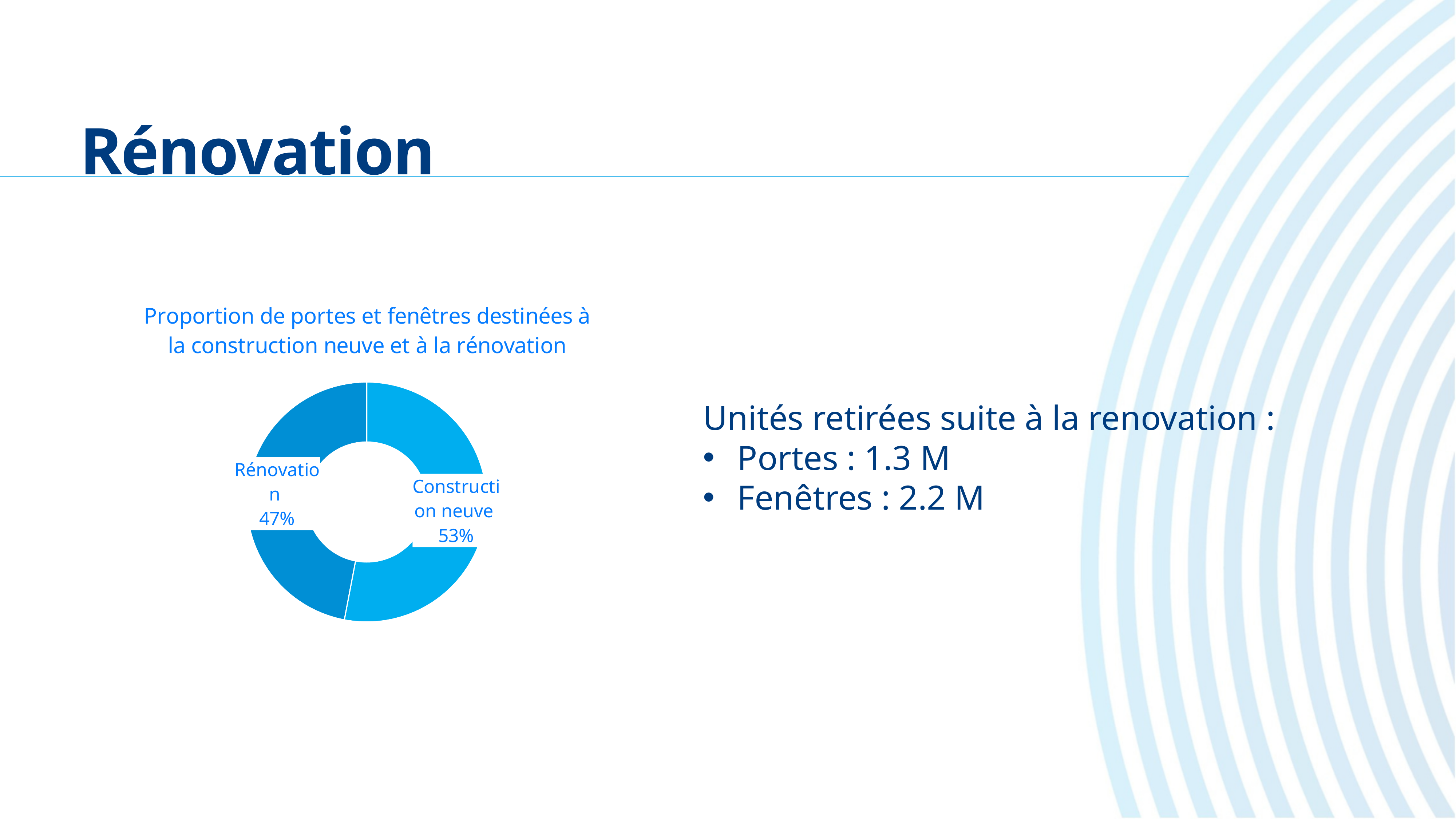
How many categories are shown in the chart? 2 Which category has the largest share in the chart? Construction neuve Is the share for Rénovation greater or less than 50%? less Which category has the smallest share in the chart? Rénovation Which is larger, the share for Rénovation or the share for Construction neuve? Construction neuve What is the difference in percentage points between Construction neuve and Rénovation? 6 What is the total of the two shares shown in the chart? 100% What kind of chart is shown on the slide? Doughnut chart What share of the doughnut chart does Rénovation represent? 47% What is the title of the chart? Proportion de portes et fenêtres destinées à la construction neuve et à la rénovation What share of the doughnut chart does Construction neuve represent? 53%